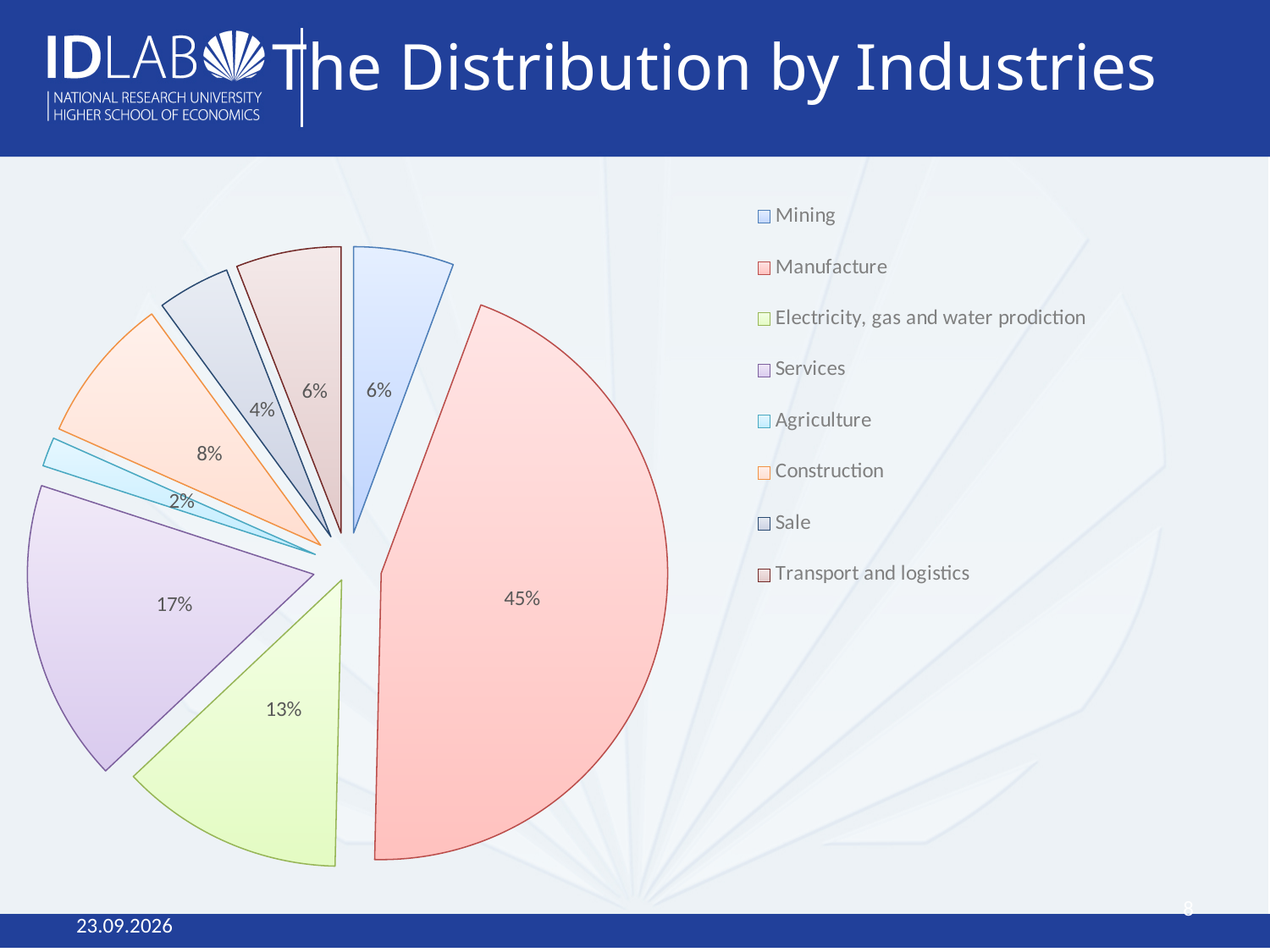
What is the value for Construction? 8% What is the value for Electricity, gas and water prodiction? 13% What share of the pie does Manufacture have? 45% What is the difference between the shares of Services and Electricity, gas and water prodiction? 4% What share of the pie does Services have? 17% Which industry has the smallest share of the pie? Agriculture What is the value for Agriculture? 2% What is the title of the slide containing the chart? The Distribution by Industries Which is larger, the share for Construction or the share for Sale? Construction How many slices does the pie chart have? 8 What type of chart is shown on the slide? Pie chart Which industry has the largest share of the pie? Manufacture